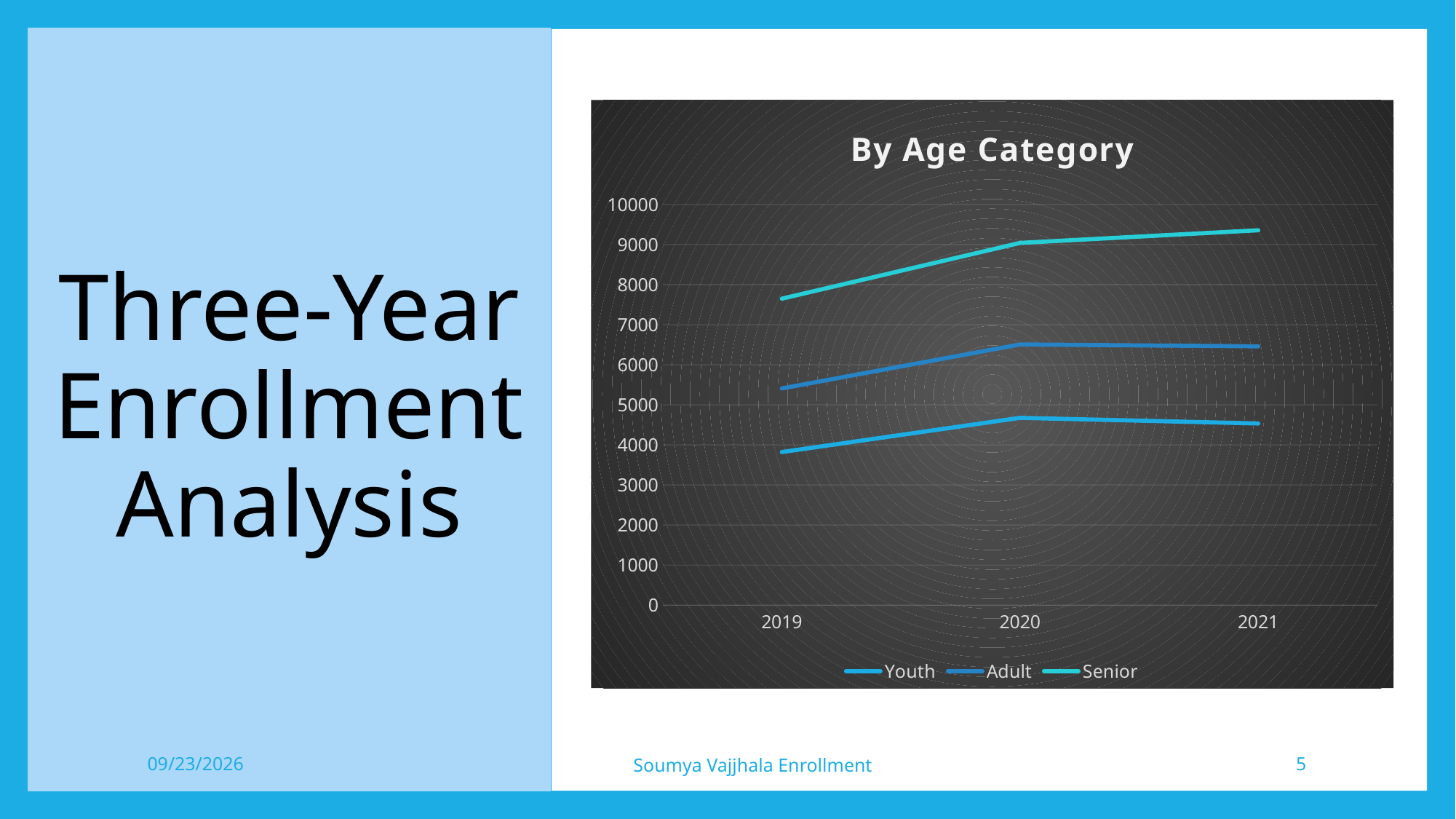
What kind of chart is shown on the slide? line chart Does the Senior series rise or fall from 2019 to 2021? rise Is the value for Youth in 2019 greater or less than 4000? less How many series does the legend list? 3 What is the title of the chart? By Age Category Which series is listed last in the legend? Senior How many years are shown on the x axis? 3